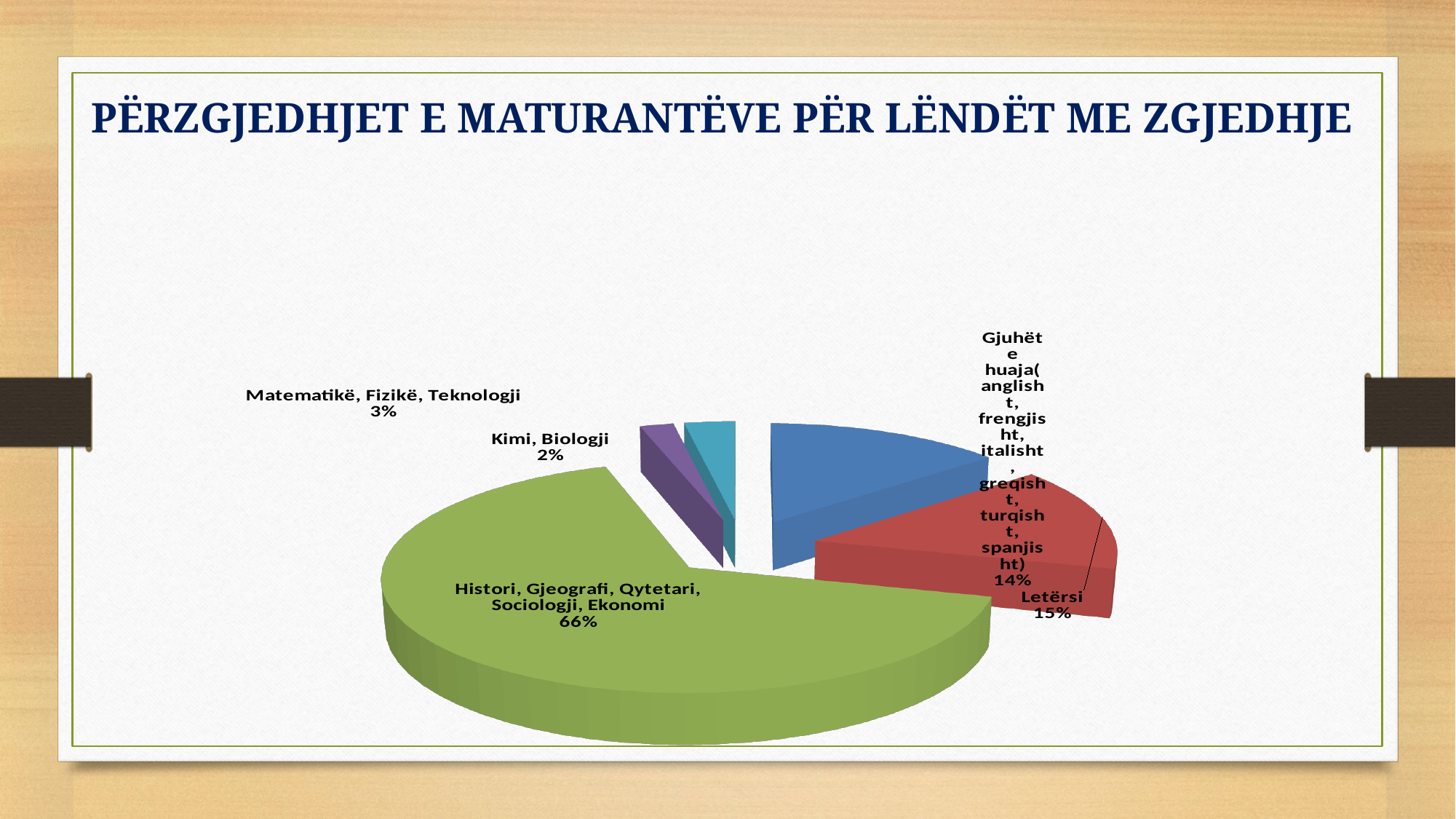
What share of the pie does Matematikë, Fizikë, Teknologji have? 3% What share of the pie does Kimi, Biologji have? 2% Which is larger, the share for Matematikë, Fizikë, Teknologji or the share for Kimi, Biologji? Matematikë, Fizikë, Teknologji What share of the pie does Histori, Gjeografi, Qytetari, Sociologji, Ekonomi have? 66% What is the difference in percentage points between Letërsi and Gjuhët e huaja? 1% What is the title of the slide containing the chart? PËRZGJEDHJET E MATURANTËVE PËR LËNDËT ME ZGJEDHJE How many slices does the pie chart have? 5 What kind of chart is shown on the slide? Pie chart Which category has the smallest slice of the pie? Kimi, Biologji Which category has the largest slice of the pie? Histori, Gjeografi, Qytetari, Sociologji, Ekonomi